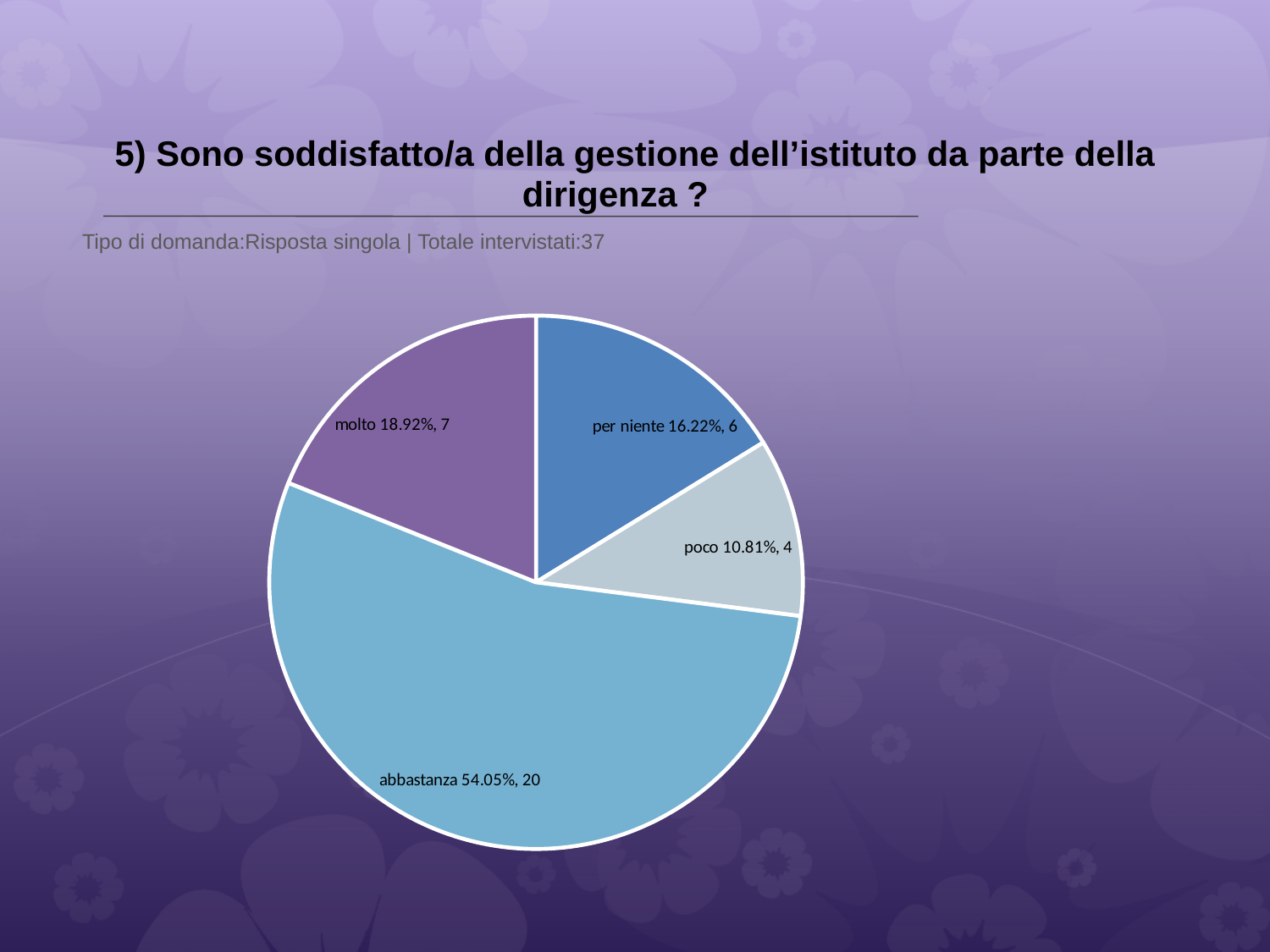
What is the total number of respondents shown in the pie chart? 37 How many slices does the pie chart have? 4 What percentage share does the 'per niente' slice have? 16.22% What is the title of the chart's question on the slide? 5) Sono soddisfatto/a della gestione dell'istituto da parte della dirigenza ? What kind of chart is shown on the slide? pie chart Which category has the smallest slice? poco How many respondents answered 'molto'? 7 Which has more respondents, 'per niente' or 'poco'? per niente Which category has the largest slice? abbastanza What percentage share does the 'abbastanza' slice have? 54.05% What is the difference in respondent count between 'abbastanza' and 'molto'? 13 How many respondents answered 'poco'? 4